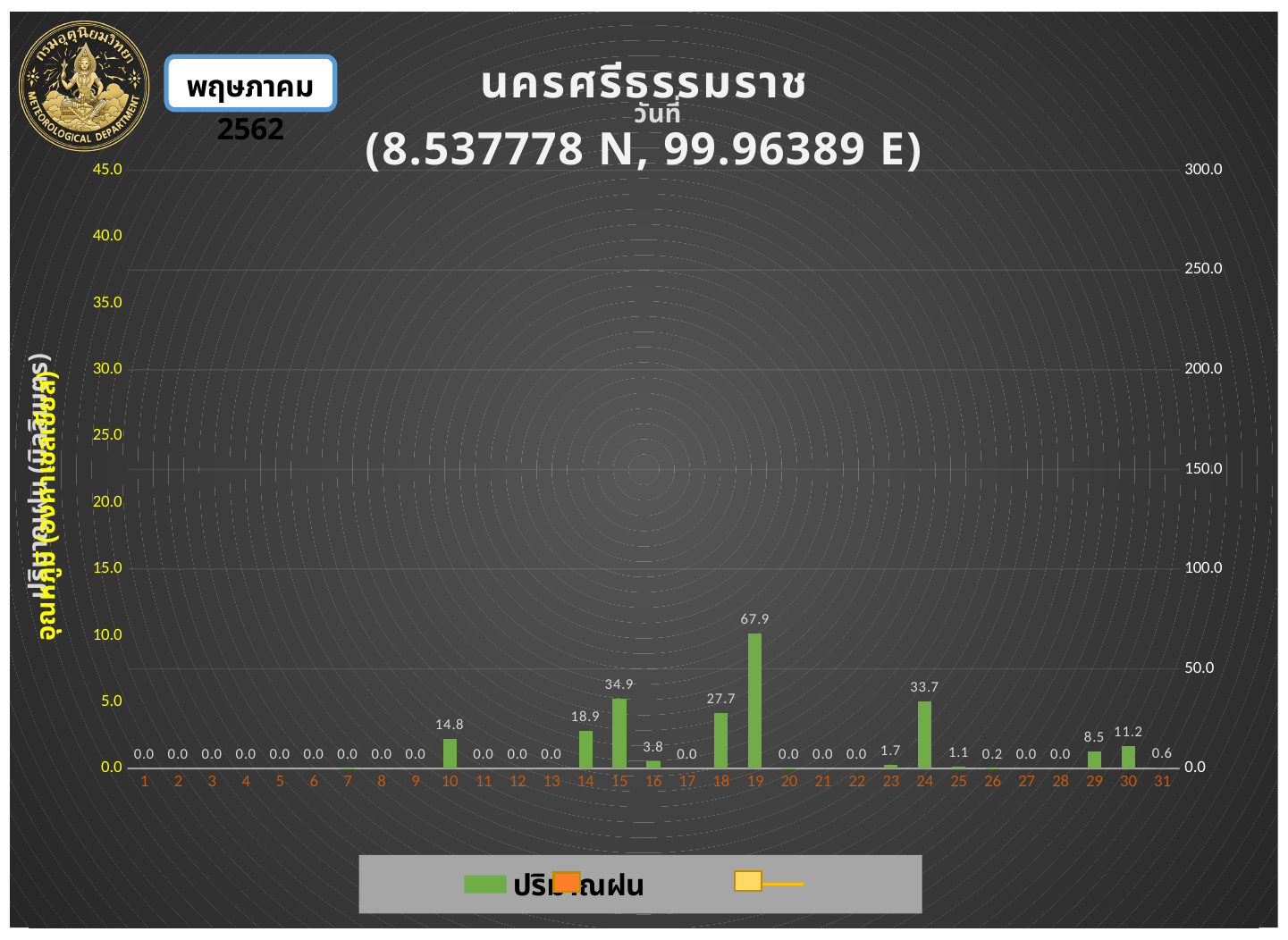
What is the rainfall value for day 31? 0.6 What is the difference between the rainfall values for day 19 and day 15? 33.0 How many days are shown on the x axis? 31 What is the rainfall value for day 15? 34.9 What is the difference between the rainfall values for day 30 and day 29? 2.7 What kind of chart is shown on the slide? bar chart What coordinates are given in the chart title? 8.537778 N, 99.96389 E Which day has the larger rainfall value, day 18 or day 24? 24 What is the rainfall value for day 10? 14.8 What is the rainfall value for day 19? 67.9 Which day has the highest rainfall value? 19 What is the rainfall value for day 24? 33.7